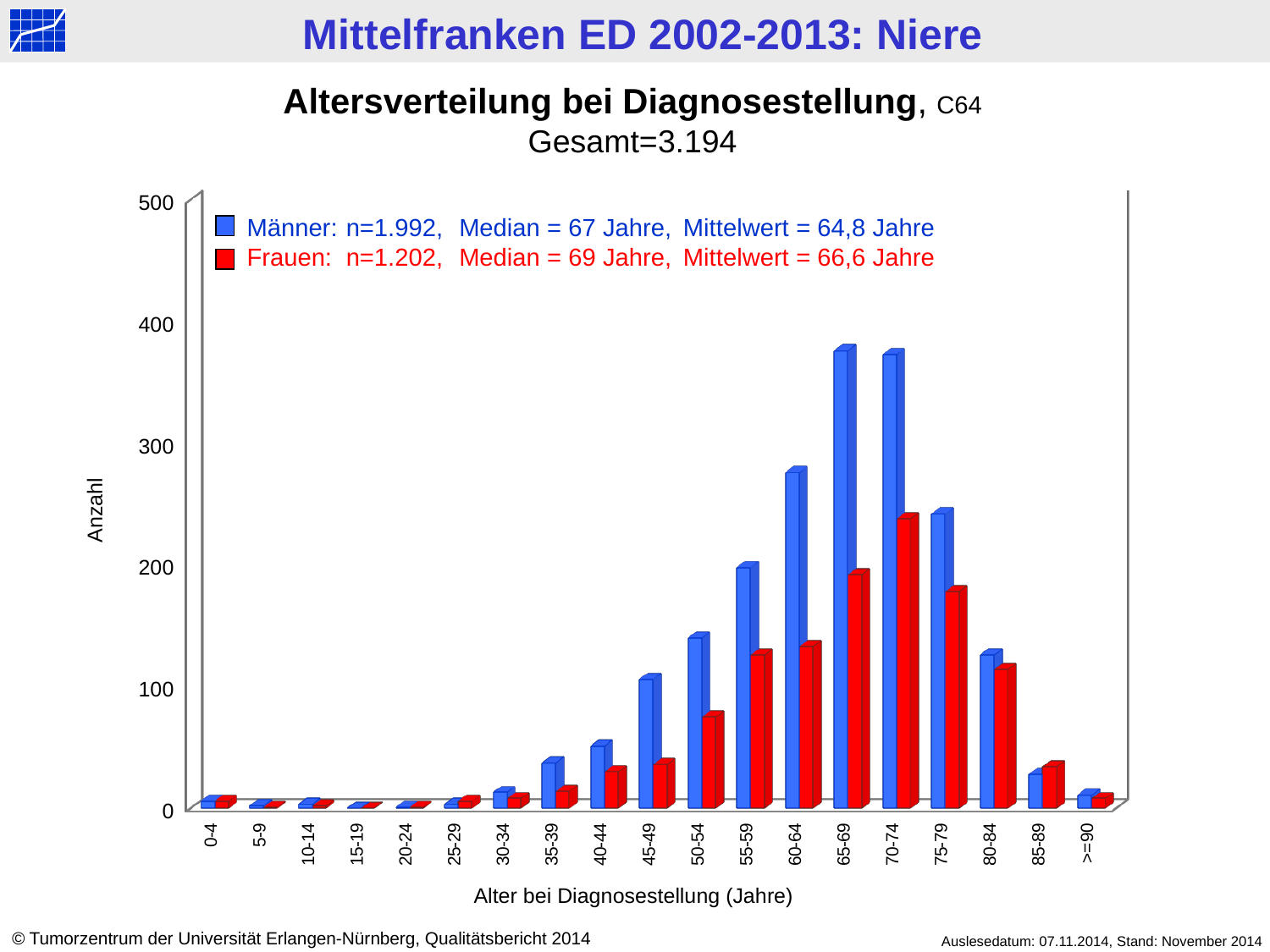
What kind of chart is shown on the slide? bar chart For Frauen, which age group has the larger value, 80-84 or 85-89? 80-84 In the 60-64 age group, which series has the larger value, Männer or Frauen? Männer Which age category has the highest value for Frauen? 70-74 Is the value for Männer in the 60-64 age group greater or less than 200? greater Do the values for Männer rise or fall from the 45-49 age group to the 65-69 age group? rise How many series does the legend list? 2 Is the value for Männer in the 65-69 age group greater or less than 300? greater Is the value for Frauen in the 75-79 age group greater or less than 200? less According to the legend, what is the n for Männer? 1.992 How many age categories are shown on the x axis? 19